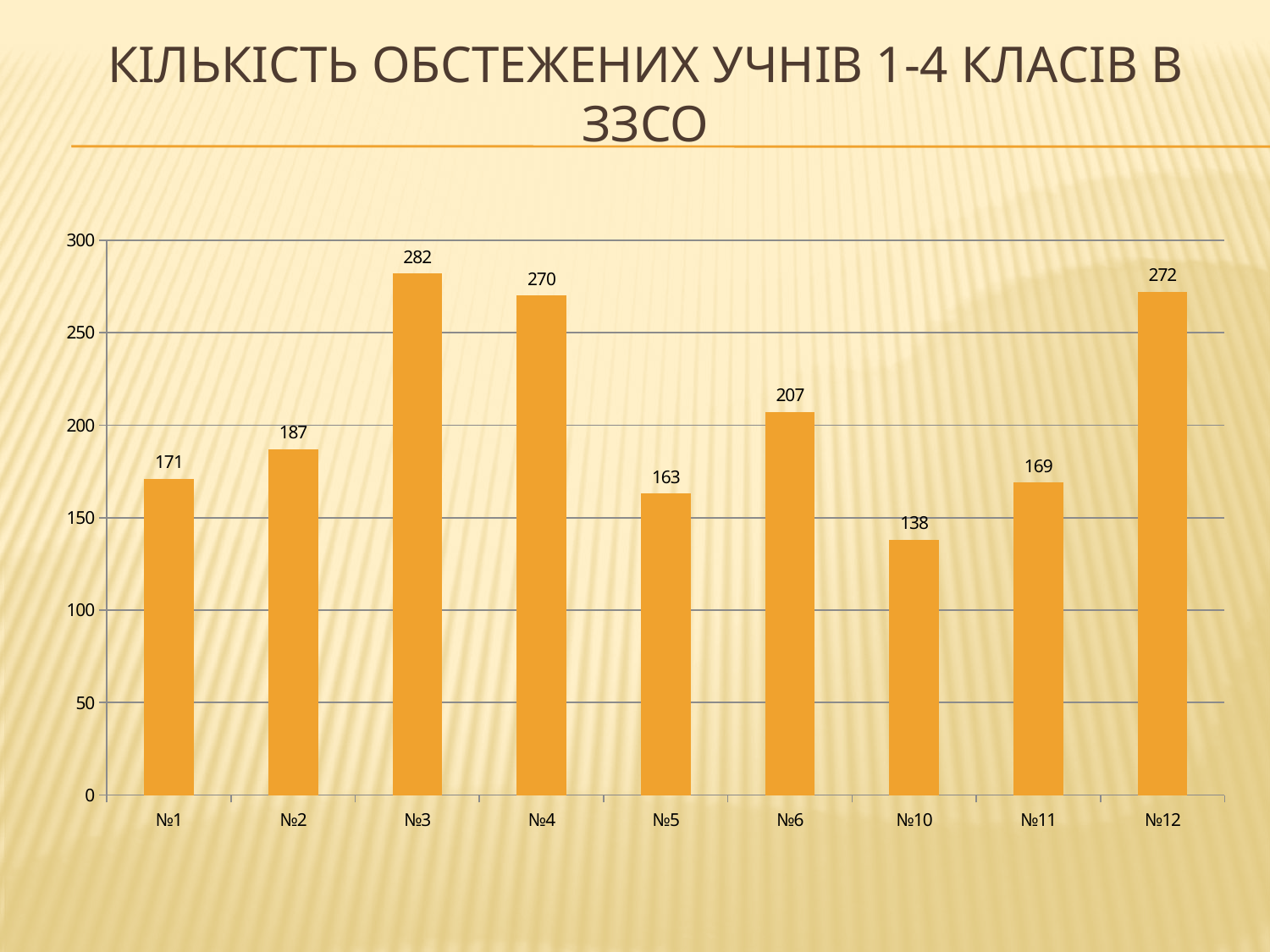
Which is larger, the value for №2 or the value for №5? №2 What kind of chart is shown on the slide? bar chart What is the value for №3? 282 What is the value for №10? 138 How many categories are shown on the x axis? 9 Which category has the highest value? №3 Is the value for №11 greater or less than 150? greater What is the difference between the values for №12 and №4? 2 What is the value for №6? 207 Which category has the lowest value? №10 What is the title of the chart? КІЛЬКІСТЬ ОБСТЕЖЕНИХ УЧНІВ 1-4 КЛАСІВ В ЗЗСО What is the difference between the values for №3 and №10? 144